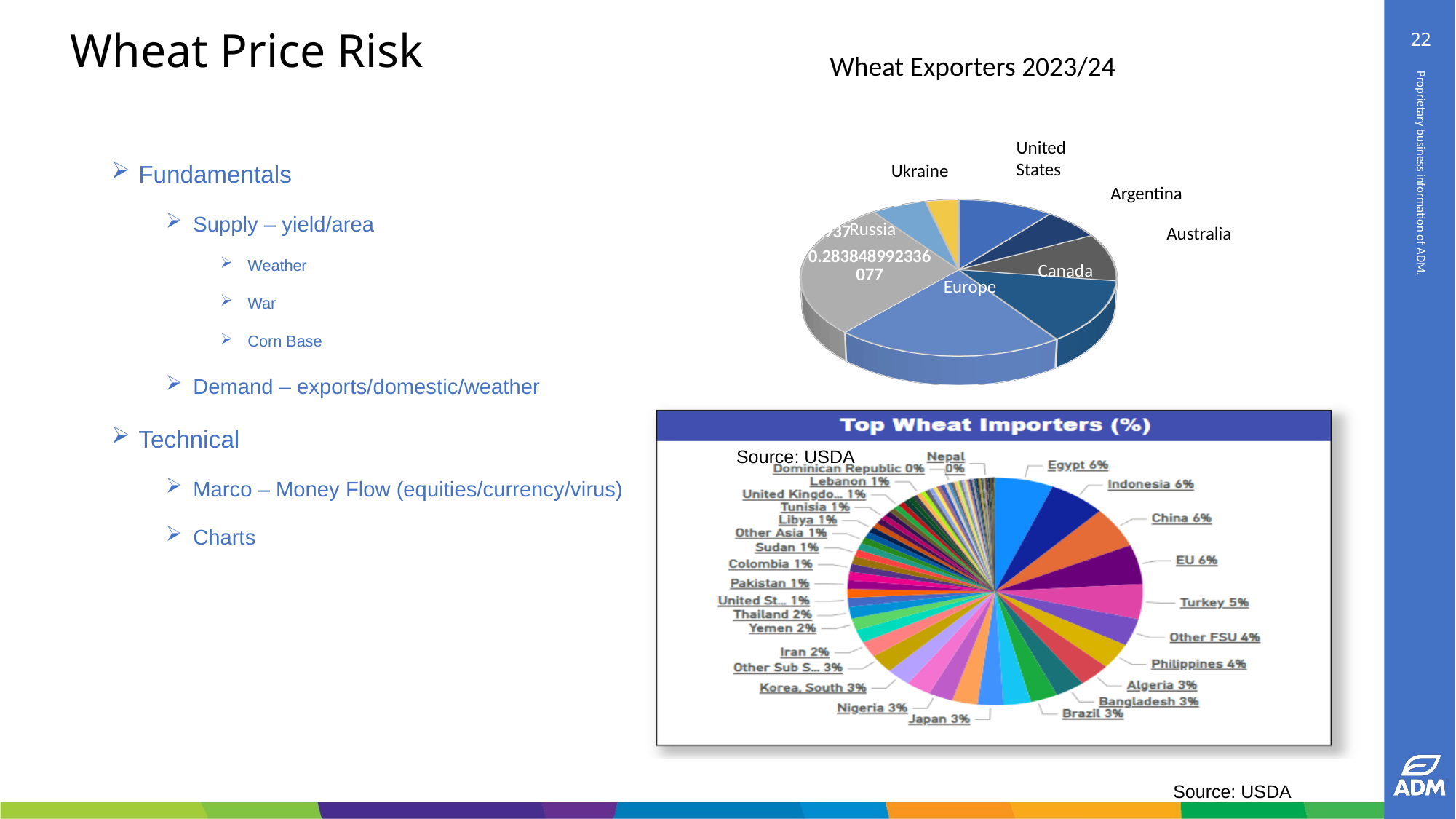
How many exporter categories are labelled in the Wheat Exporters 2023/24 chart? 7 In the Top Wheat Importers (%) chart, which has the larger share, Other FSU or Brazil? Other FSU What is the title of the pie chart at the top right of the slide? Wheat Exporters 2023/24 In the Wheat Exporters 2023/24 chart, what data label is printed on the Russia slice? 0.283848992336077 In the Top Wheat Importers (%) chart, what share is shown for the Philippines? 4% In the Top Wheat Importers (%) chart, what is the difference between Egypt's share and Turkey's share? 1% In the Top Wheat Importers (%) chart, what share is shown for Nepal? 0% In the Top Wheat Importers (%) chart, what share is shown for Iran? 2% In the Top Wheat Importers (%) chart, which has the larger share, Turkey or Algeria? Turkey What kind of chart is the Wheat Exporters 2023/24 chart? Pie chart In the Top Wheat Importers (%) chart, what share is shown for Turkey? 5% What source is cited for the Top Wheat Importers (%) chart? USDA